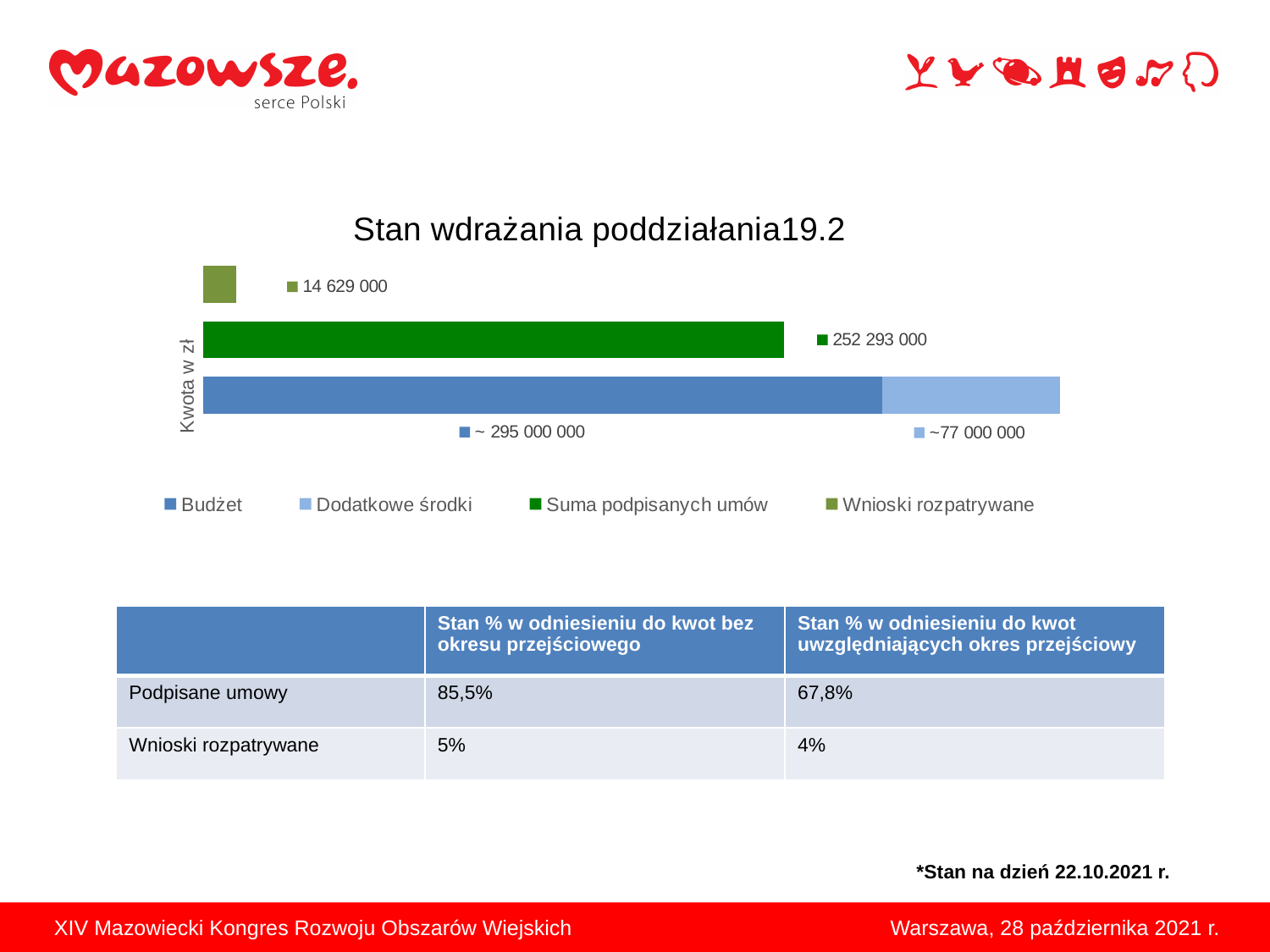
What is the title of the chart? Stan wdrażania poddziałania19.2 What kind of chart is shown on the slide? bar chart Which is larger, the bar for Budżet or the bar for Suma podpisanych umów? Budżet What is the value shown for Suma podpisanych umów? 252 293 000 Which series has the longest bar in the chart? Budżet What is the value shown for Wnioski rozpatrywane? 14 629 000 What is the difference between the values for Suma podpisanych umów and Wnioski rozpatrywane? 237 664 000 Which is larger, the bar for Dodatkowe środki or the bar for Wnioski rozpatrywane? Dodatkowe środki How many series does the chart legend list? 4 Which series has the shortest bar in the chart? Wnioski rozpatrywane What is the label on the vertical axis of the chart? Kwota w zł